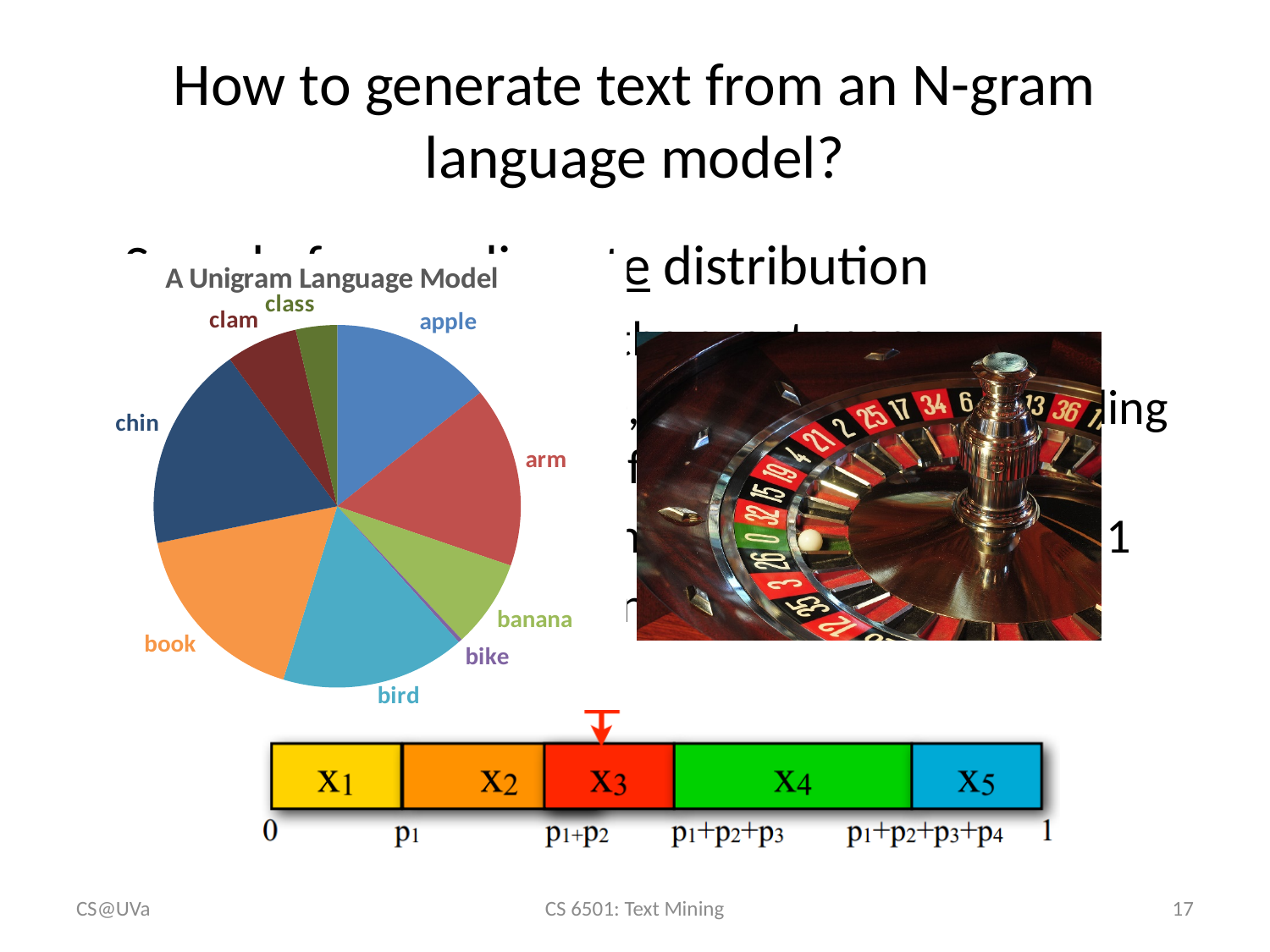
How many slices does the pie chart "A Unigram Language Model" have? 9 In the pie chart "A Unigram Language Model", which slice is larger, clam or bird? bird In the pie chart "A Unigram Language Model", what colour is the slice labelled book? orange In the pie chart "A Unigram Language Model", which word has the smallest slice? bike In the pie chart "A Unigram Language Model", which slice is larger, clam or book? book In the pie chart "A Unigram Language Model", which slice is larger, bike or banana? banana What kind of chart is "A Unigram Language Model"? pie chart What is the title of the pie chart on the slide? A Unigram Language Model